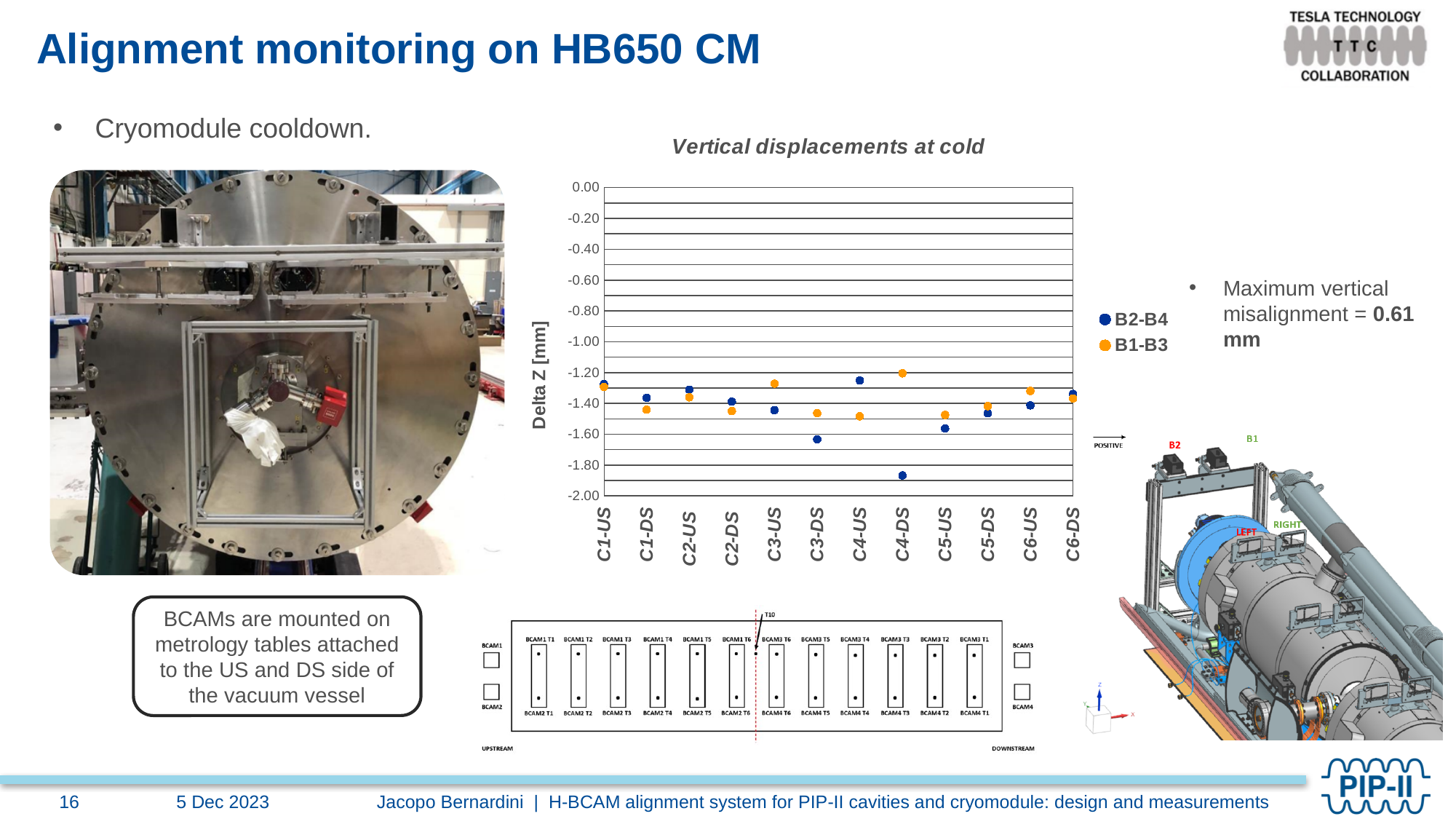
In the 'Vertical displacements at cold' chart, is the B2-B4 value for C3-DS greater or less than -1.60? less How many series does the legend of the 'Vertical displacements at cold' chart list? 2 In the 'Vertical displacements at cold' chart, which series has the higher value at C4-DS, B2-B4 or B1-B3? B1-B3 In the 'Vertical displacements at cold' chart, is the B1-B3 value for C4-DS greater or less than -1.40? greater How many categories are shown on the x axis of the 'Vertical displacements at cold' chart? 12 What is the label of the vertical axis of the 'Vertical displacements at cold' chart? Delta Z [mm] In the 'Vertical displacements at cold' chart, which series has the higher value at C4-US, B2-B4 or B1-B3? B2-B4 What kind of chart is used to show the vertical displacements at cold? scatter chart What is the title of the chart on the slide? Vertical displacements at cold In the 'Vertical displacements at cold' chart, is the B2-B4 value for C1-US greater or less than -1.40? greater In the 'Vertical displacements at cold' chart, at which category does the B2-B4 series reach its lowest value? C4-DS